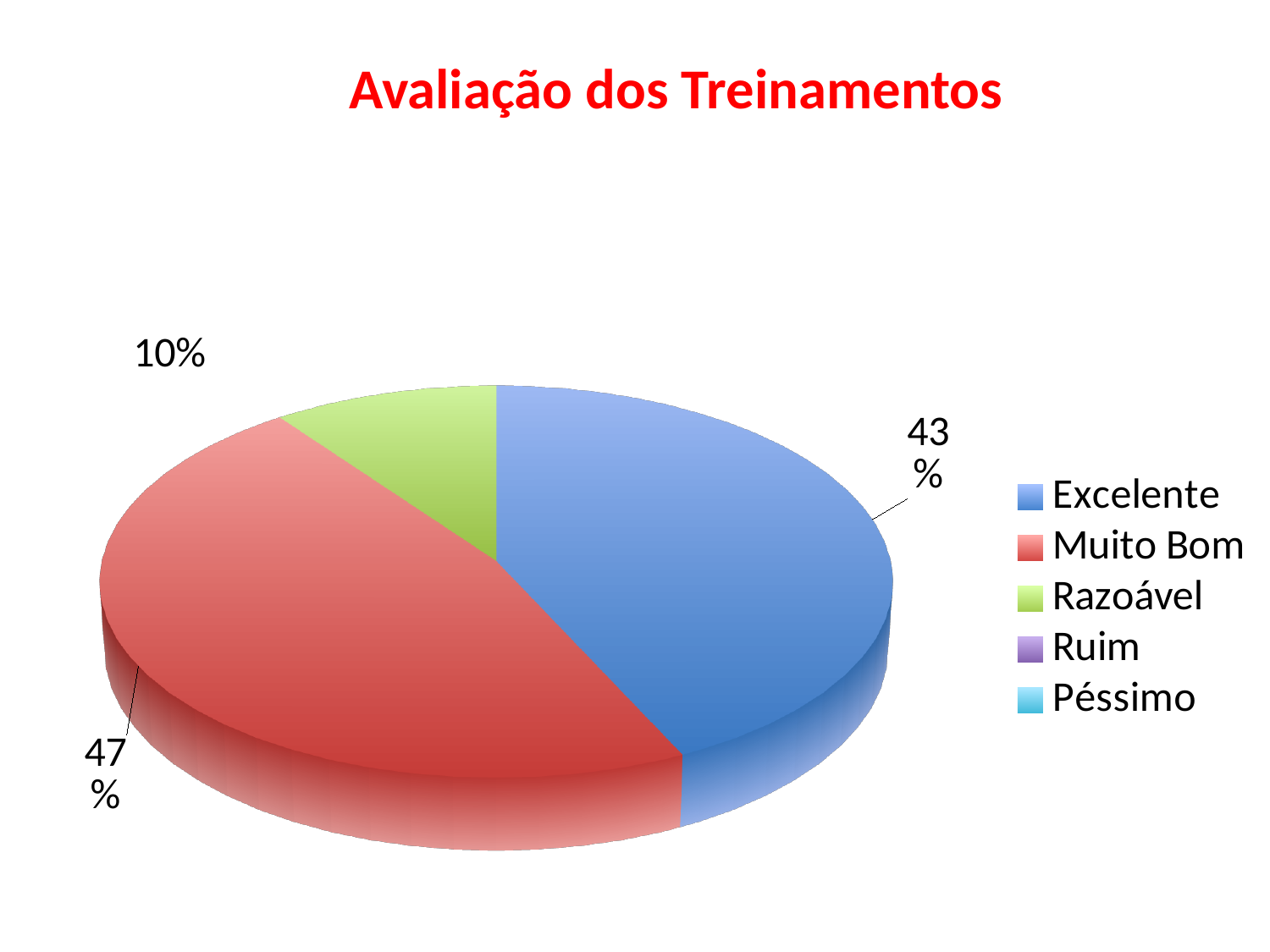
Which category has the largest slice of the pie? Muito Bom Which is larger, the slice for Excelente or the slice for Muito Bom? Muito Bom What percentage of the pie is labelled for Muito Bom? 47% What colour is the slice for Razoável? Green How many entries does the legend list? 5 What percentage of the pie is labelled for Excelente? 43% What is the difference in percentage points between Muito Bom and Excelente? 4 What kind of chart is shown on the slide? Pie chart What share of the pie does Razoável represent? 10% Which of the labelled slices is the smallest? Razoável How many slices are visible in the pie? 3 What is the title of the chart? Avaliação dos Treinamentos